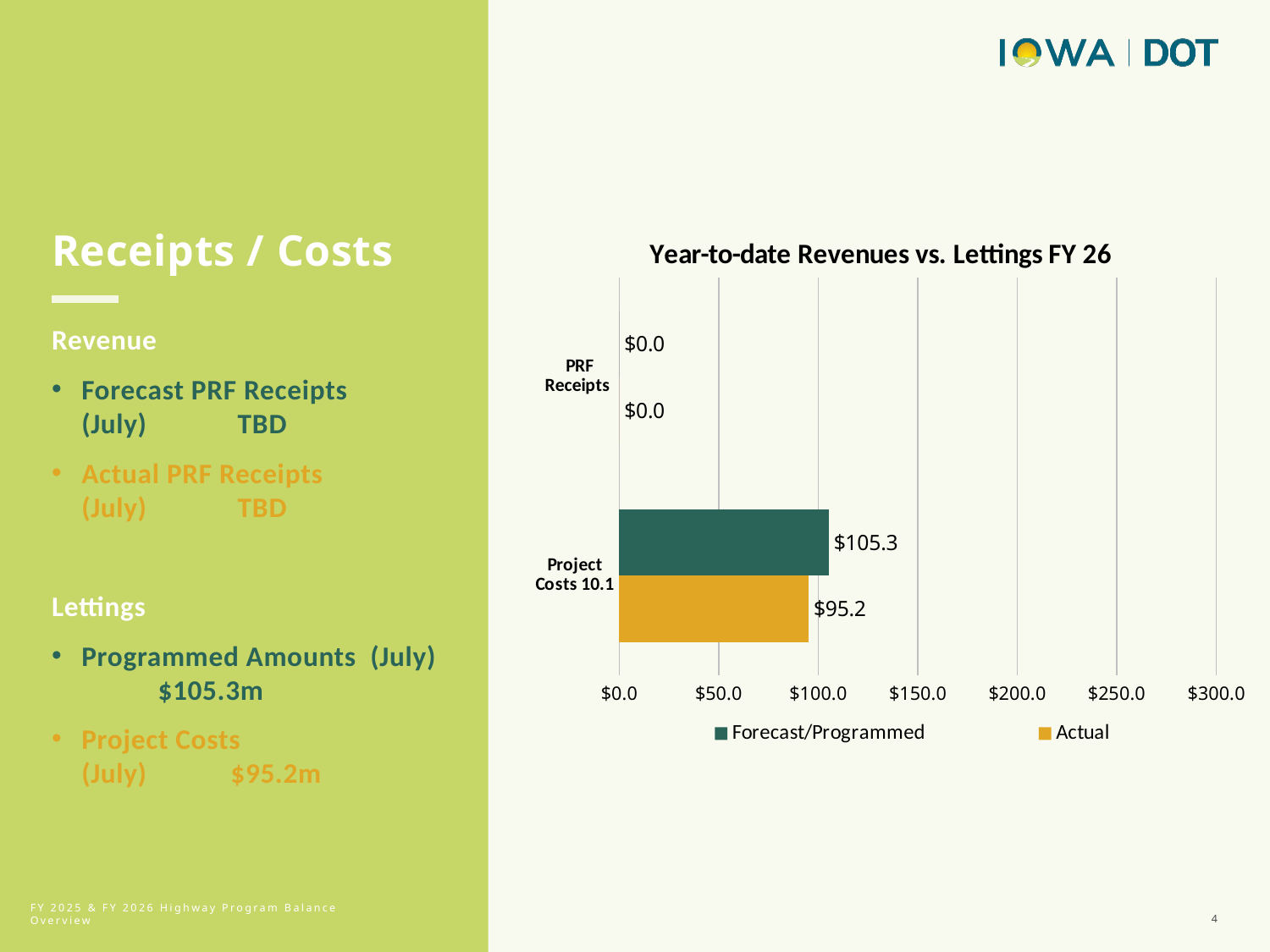
What is the difference between the Forecast/Programmed and Actual values for Project Costs 10.1? $10.1 What is the Actual value for PRF Receipts? $0.0 For Project Costs 10.1, which is larger: the Forecast/Programmed value or the Actual value? Forecast/Programmed What type of chart is shown on the slide? bar chart How many categories are shown on the chart's vertical axis? 2 What is the Forecast/Programmed value for Project Costs 10.1? $105.3 How many series does the chart legend list? 2 What is the Forecast/Programmed value for PRF Receipts? $0.0 What is the Actual value for Project Costs 10.1? $95.2 Is the Actual value for Project Costs 10.1 greater or less than $100.0? less What are the two series named in the legend? Forecast/Programmed and Actual What is the title of the chart? Year-to-date Revenues vs. Lettings FY 26